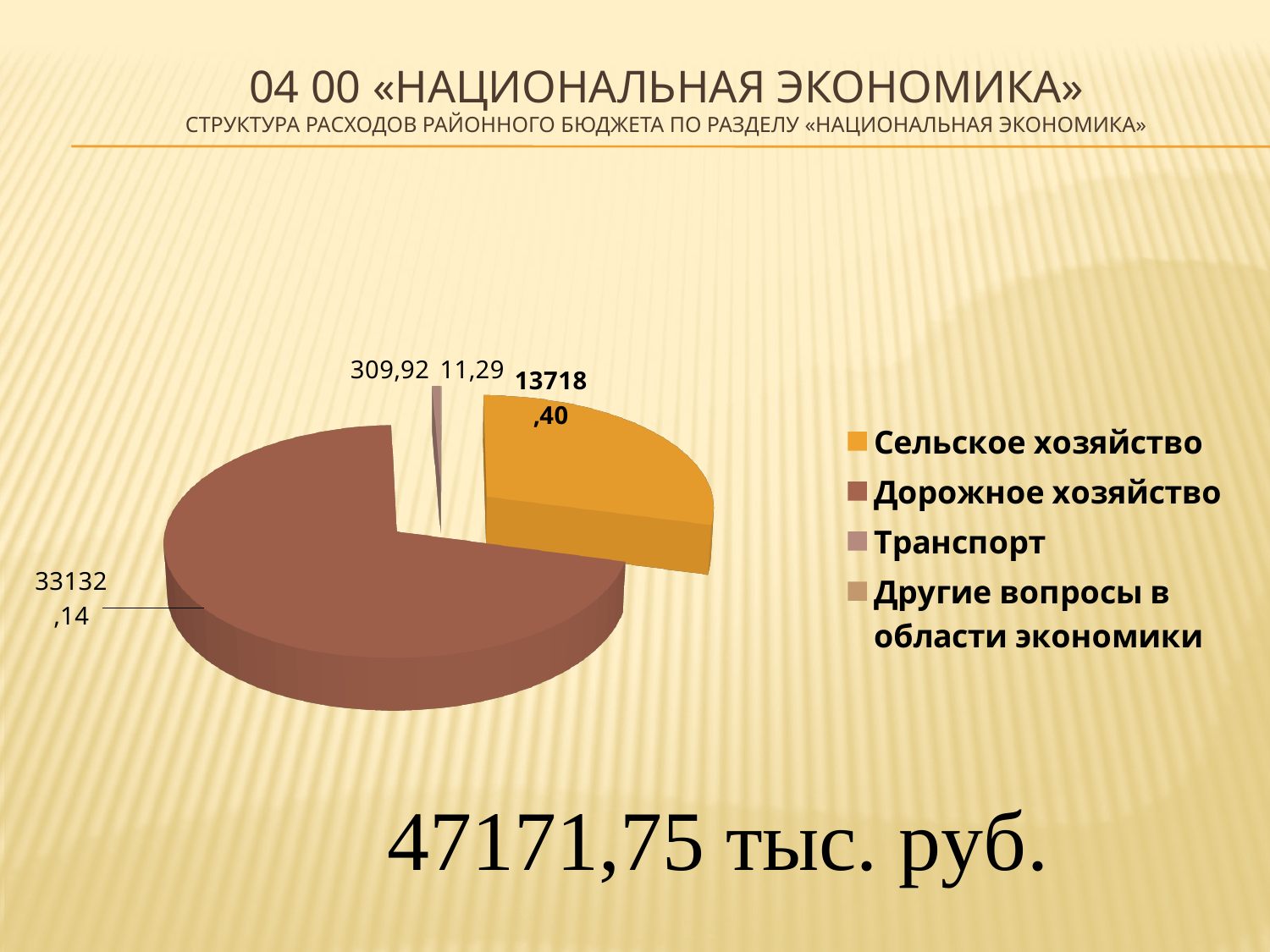
Which colour represents Сельское хозяйство in the legend? Orange What is the value for Дорожное хозяйство? 33132,14 How many categories does the pie chart have? 4 What is the value for Другие вопросы в области экономики? 11,29 What is the total of all slices shown on the slide? 47171,75 тыс. руб. What kind of chart is shown on the slide? Pie chart Which category has the largest slice of the pie? Дорожное хозяйство Which category has the smallest slice of the pie? Другие вопросы в области экономики What is the value for Сельское хозяйство? 13718,40 Which is larger, the value for Транспорт or the value for Сельское хозяйство? Сельское хозяйство What is the value for Транспорт? 309,92 What is the difference between the values for Дорожное хозяйство and Сельское хозяйство? 19413,74